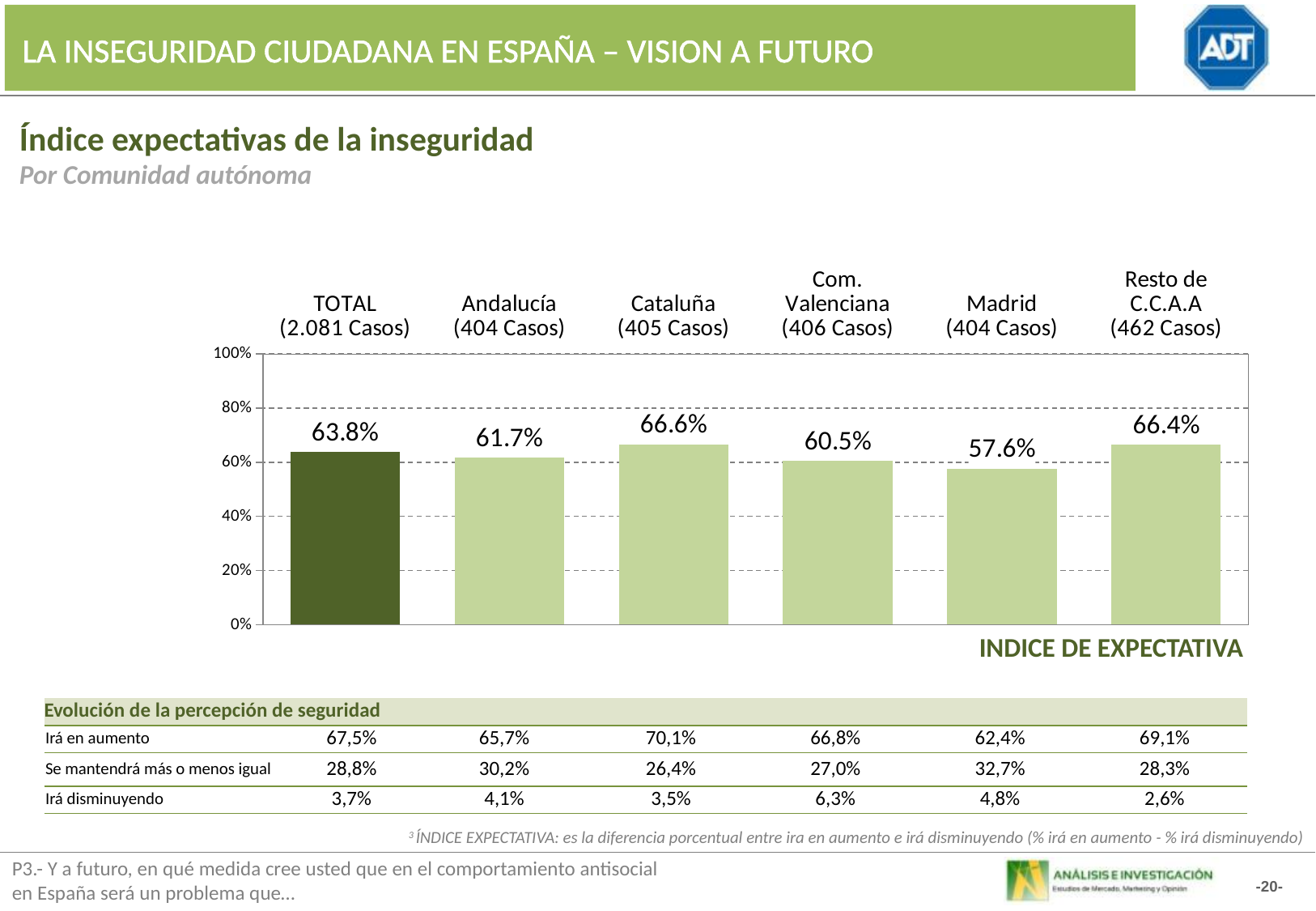
What is the difference between the TOTAL bar and the Madrid bar? 6.2 percentage points What is the value of the bar for Com. Valenciana (406 Casos)? 60.5% How many bars are shown in the chart? 6 Which category has the highest bar in the chart? Cataluña What is the value of the bar for Madrid (404 Casos)? 57.6% What kind of chart is shown on the slide? Bar chart Which category has the lowest bar in the chart? Madrid Is the value for Madrid greater or less than 60%? less Which is larger, the bar for Andalucía or the bar for Resto de C.C.A.A? Resto de C.C.A.A What is the value of the bar for Cataluña (405 Casos)? 66.6% What is the value of the TOTAL (2.081 Casos) bar? 63.8% Which bar is drawn in a darker green than the others? TOTAL (2.081 Casos)